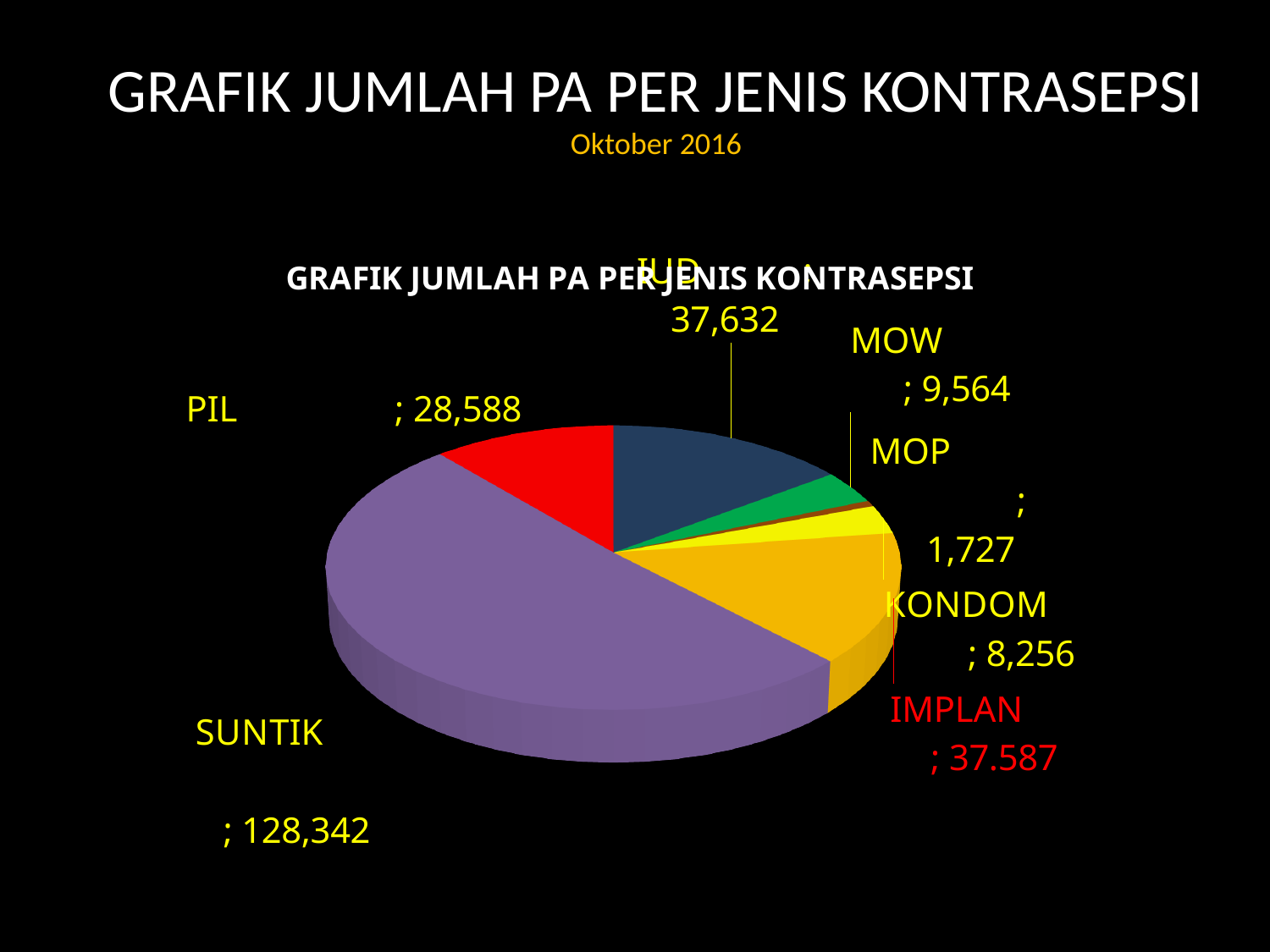
Which category has the largest slice in the pie chart? SUNTIK What is the difference between the values for SUNTIK and PIL? 99,754 Which category has the smallest slice in the pie chart? MOP What is the difference between the values for KONDOM and MOP? 6,529 What is the value for IUD in the pie chart? 37,632 What is the value for PIL in the pie chart? 28,588 How many categories are shown in the pie chart? 7 What is the value for SUNTIK in the pie chart? 128,342 What kind of chart is shown on the slide? Pie chart Which is larger, the value for PIL or the value for MOW? PIL What is the value for MOW in the pie chart? 9,564 What is the value for KONDOM in the pie chart? 8,256